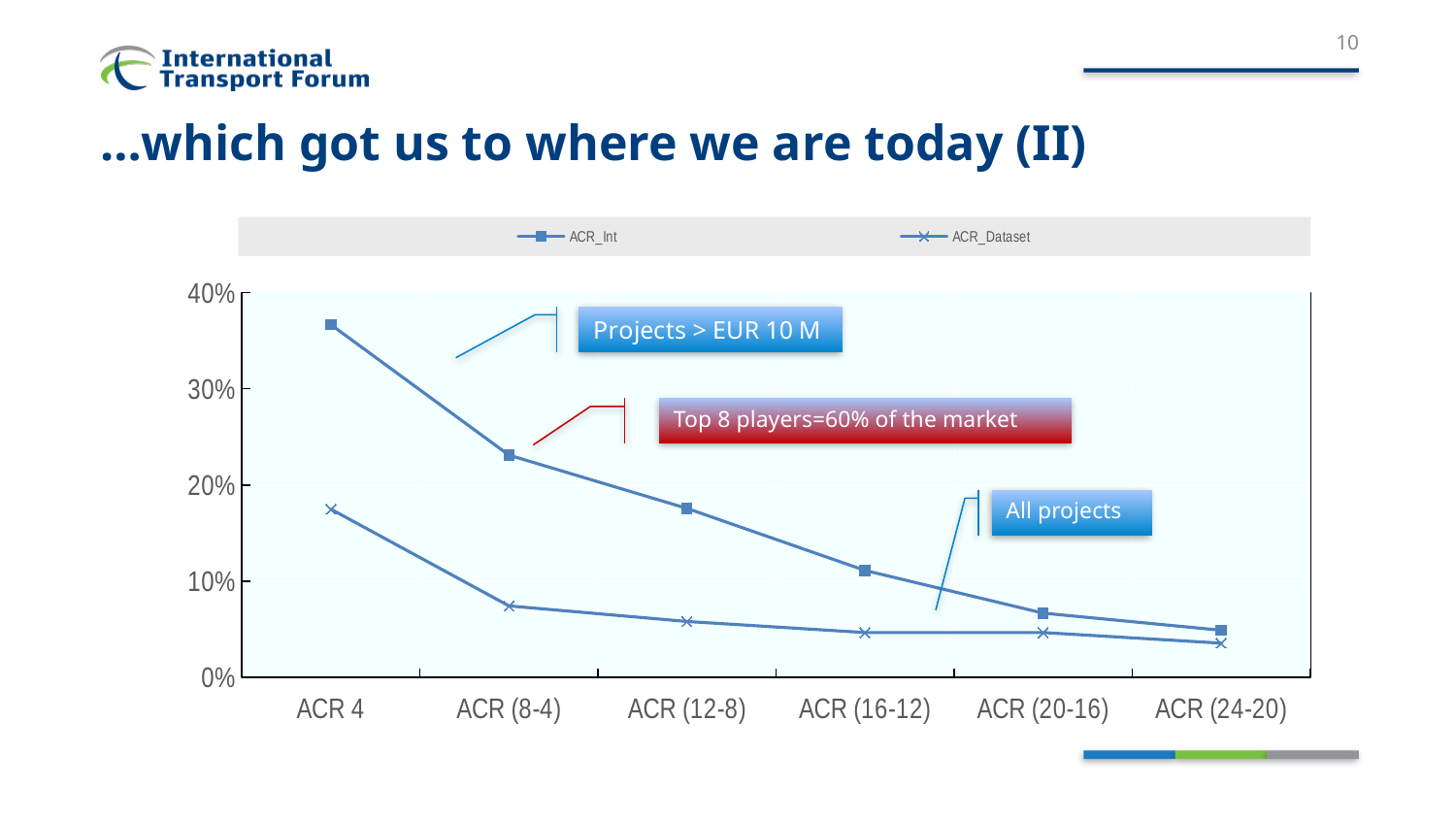
How many series does the legend list? 2 How many categories are shown on the x axis? 6 What kind of chart is shown on the slide? line chart At ACR (12-8), which series has the larger value, ACR_Int or ACR_Dataset? ACR_Int Is the value of ACR_Dataset for ACR (8-4) greater or less than 10%? less Do the values of the ACR_Int series rise or fall from ACR 4 to ACR (24-20)? fall Which category has the lowest value for the ACR_Dataset series? ACR (24-20) Is the value of ACR_Int for ACR 4 greater or less than 30%? greater Which series is marked with x markers in the legend? ACR_Dataset Which category has the highest value for the ACR_Int series? ACR 4 Is the value of ACR_Int for ACR (8-4) greater or less than 20%? greater